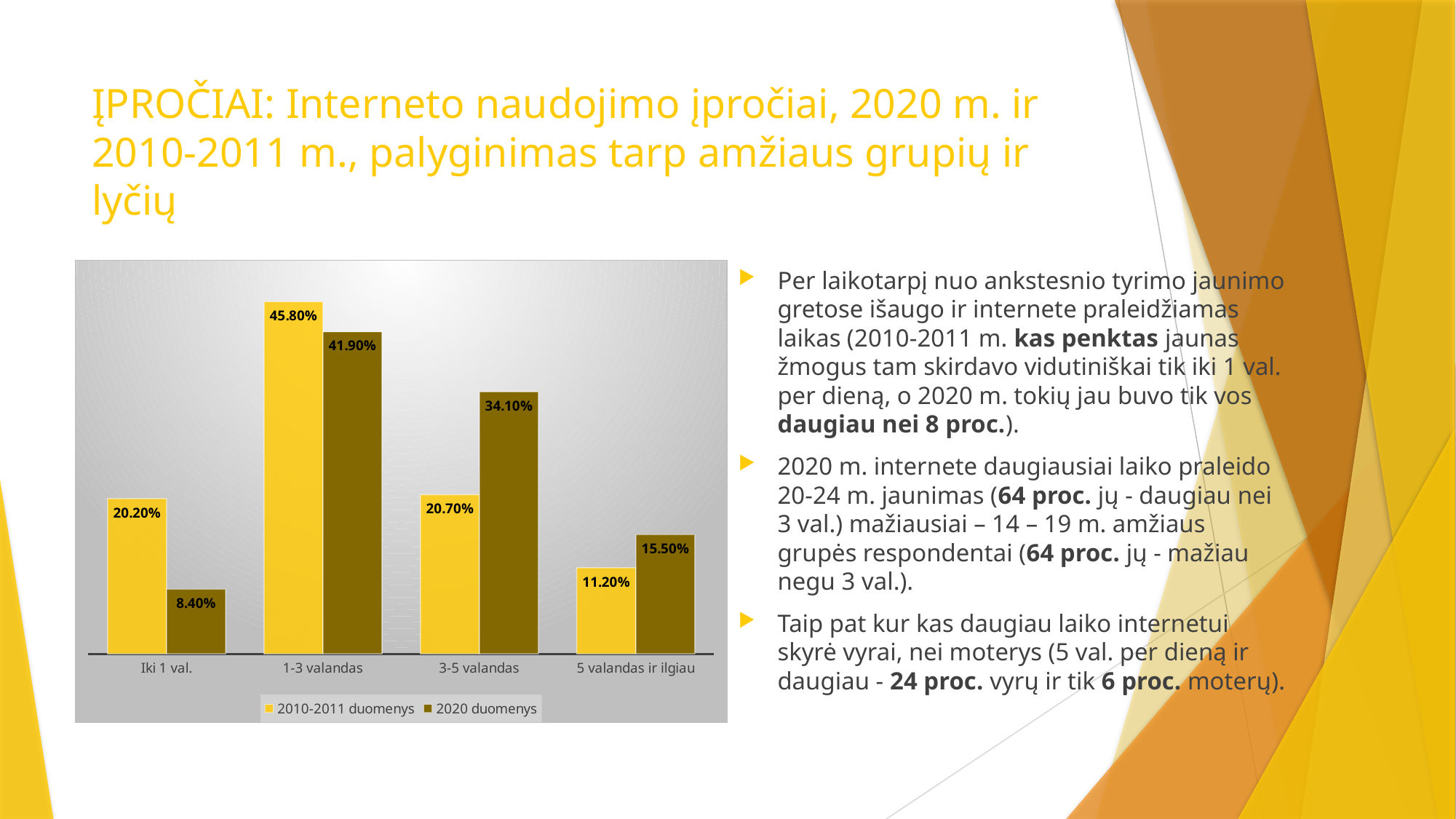
What is the value for "Iki 1 val." in the "2020 duomenys" series? 8.40% What is the value for "3-5 valandas" in the "2020 duomenys" series? 34.10% How many categories are shown on the x axis of the chart? 4 What is the value for "5 valandas ir ilgiau" in the "2010-2011 duomenys" series? 11.20% Which series is shown in the darker brown colour in the chart? 2020 duomenys What type of chart is shown on the slide? bar chart How many series does the chart legend list? 2 What is the difference between the "2010-2011 duomenys" and "2020 duomenys" values for "Iki 1 val."? 11.80% For "3-5 valandas", which series has the larger value, "2010-2011 duomenys" or "2020 duomenys"? 2020 duomenys Which category has the lowest value in the "2010-2011 duomenys" series? 5 valandas ir ilgiau What is the value for "1-3 valandas" in the "2010-2011 duomenys" series? 45.80% Which category has the highest value in the "2020 duomenys" series? 1-3 valandas